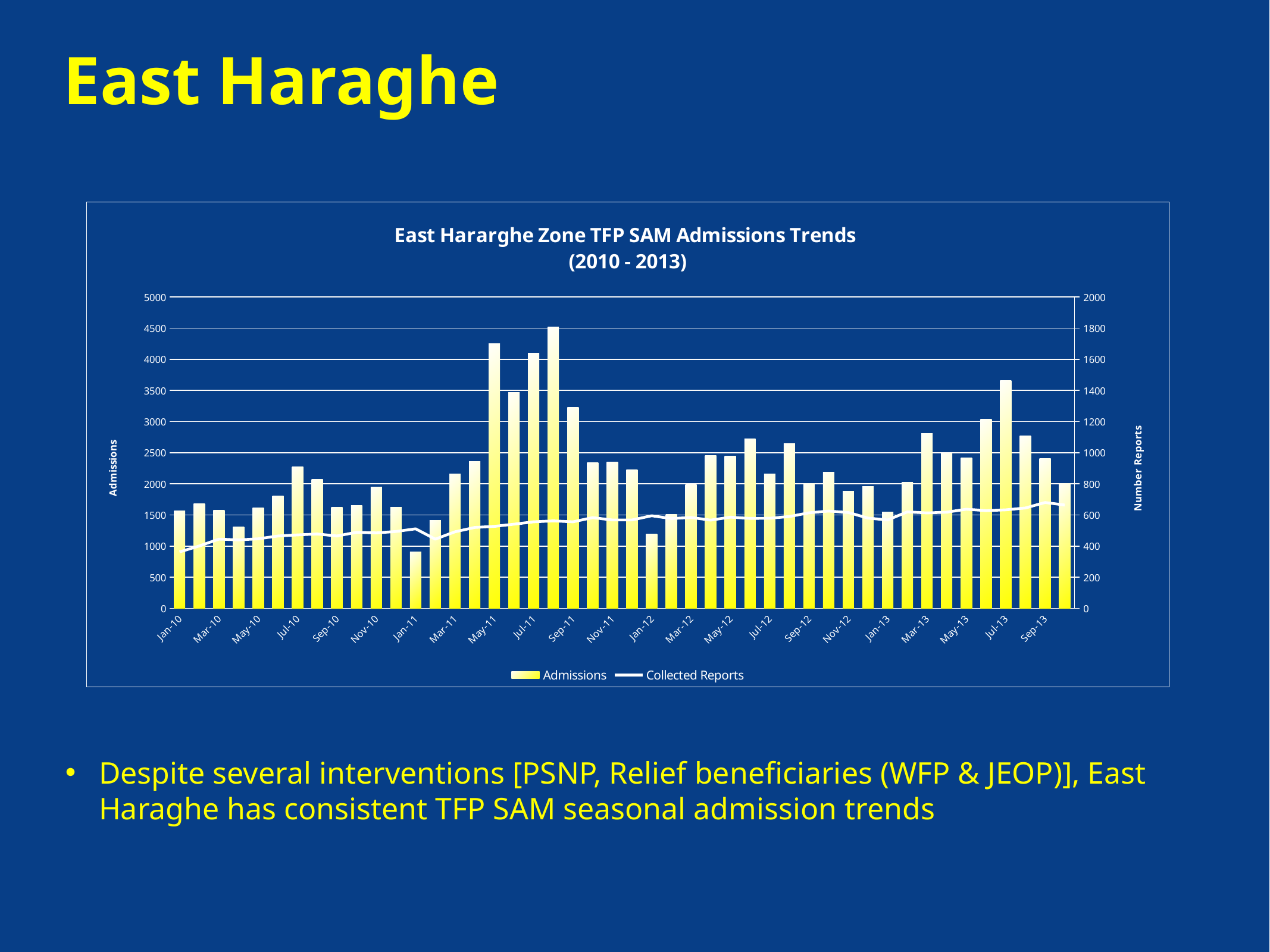
In which year does the highest Admissions bar occur? 2011 Which labelled month has the lowest Admissions bar? Jan-11 Which has the higher Admissions value, Jul-12 or Jul-13? Jul-13 Does the Collected Reports line generally rise or fall from Jan-10 to Sep-13? rise Is the Admissions value for Jan-12 greater or less than 1500? less Is the Admissions value for Jan-11 greater or less than 1000? less Which series is drawn as a line rather than bars? Collected Reports Is the Admissions value for Jul-13 greater or less than 3500? greater How many series does the chart legend list? 2 What is the title of the chart? East Hararghe Zone TFP SAM Admissions Trends (2010 - 2013) What kind of chart is used for the Admissions series? Bar chart